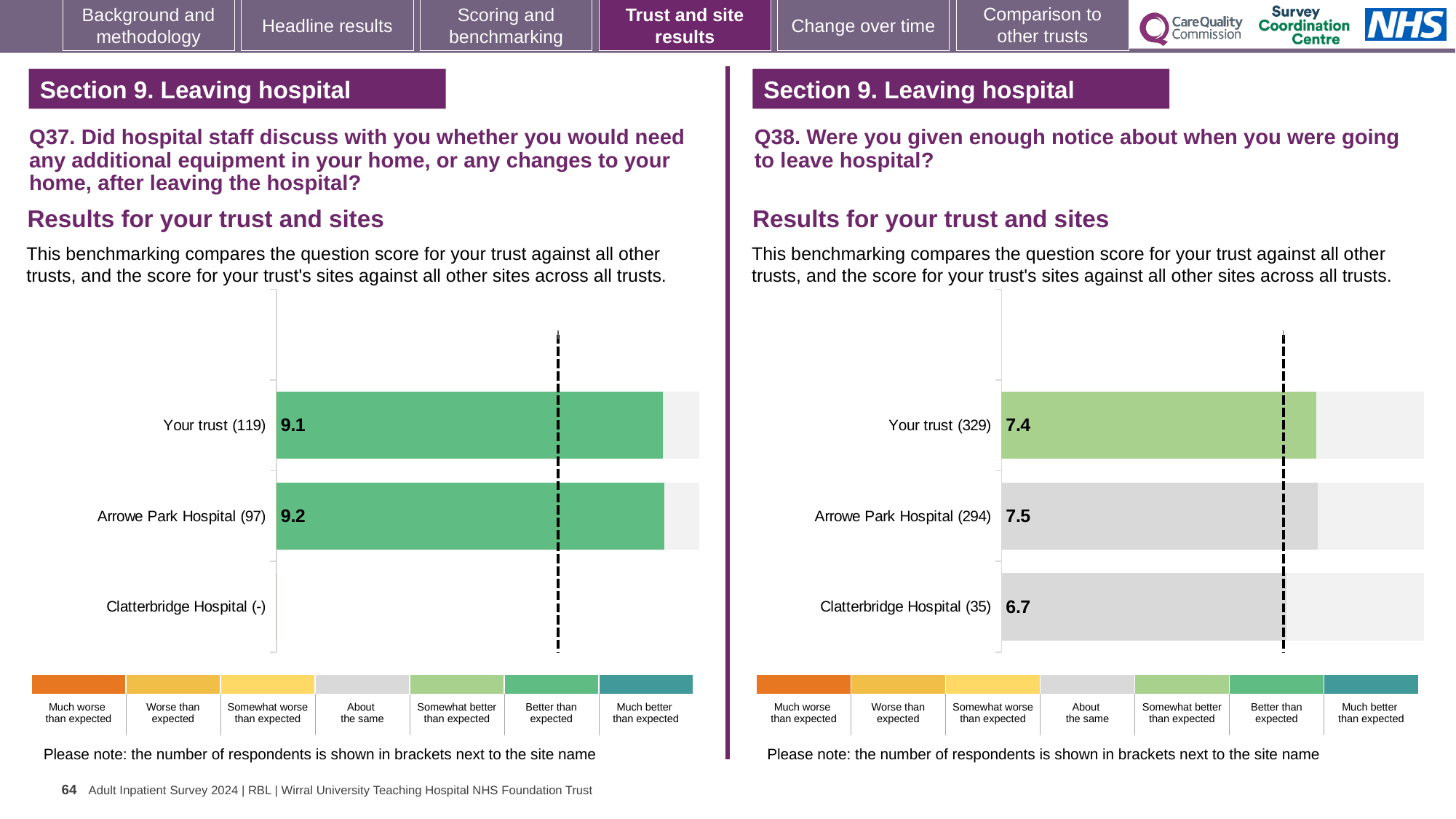
In the Q38 chart on the right, which site or trust has the lowest score? Clatterbridge Hospital In the Q38 chart on the right, what is the score for Your trust? 7.4 In the Q38 chart on the right, what is the difference between the scores for Arrowe Park Hospital and Clatterbridge Hospital? 0.8 In the Q38 chart on the right, how many respondents are shown for Arrowe Park Hospital? 294 How many rows (trust and sites) are listed in the Q38 chart on the right? 3 In the Q37 chart on the left, what is the score for Your trust? 9.1 In the Q38 chart on the right, what is the score for Clatterbridge Hospital? 6.7 In the Q38 chart on the right, which benchmark category does the colour of the Your trust bar correspond to? Somewhat better than expected In the Q37 chart on the left, what is the difference between the scores for Arrowe Park Hospital and Your trust? 0.1 In the Q37 chart on the left, how many respondents are shown for Your trust? 119 What type of chart is used for the Q37 results on the left? Bar chart In the Q37 chart on the left, what is the score for Arrowe Park Hospital? 9.2